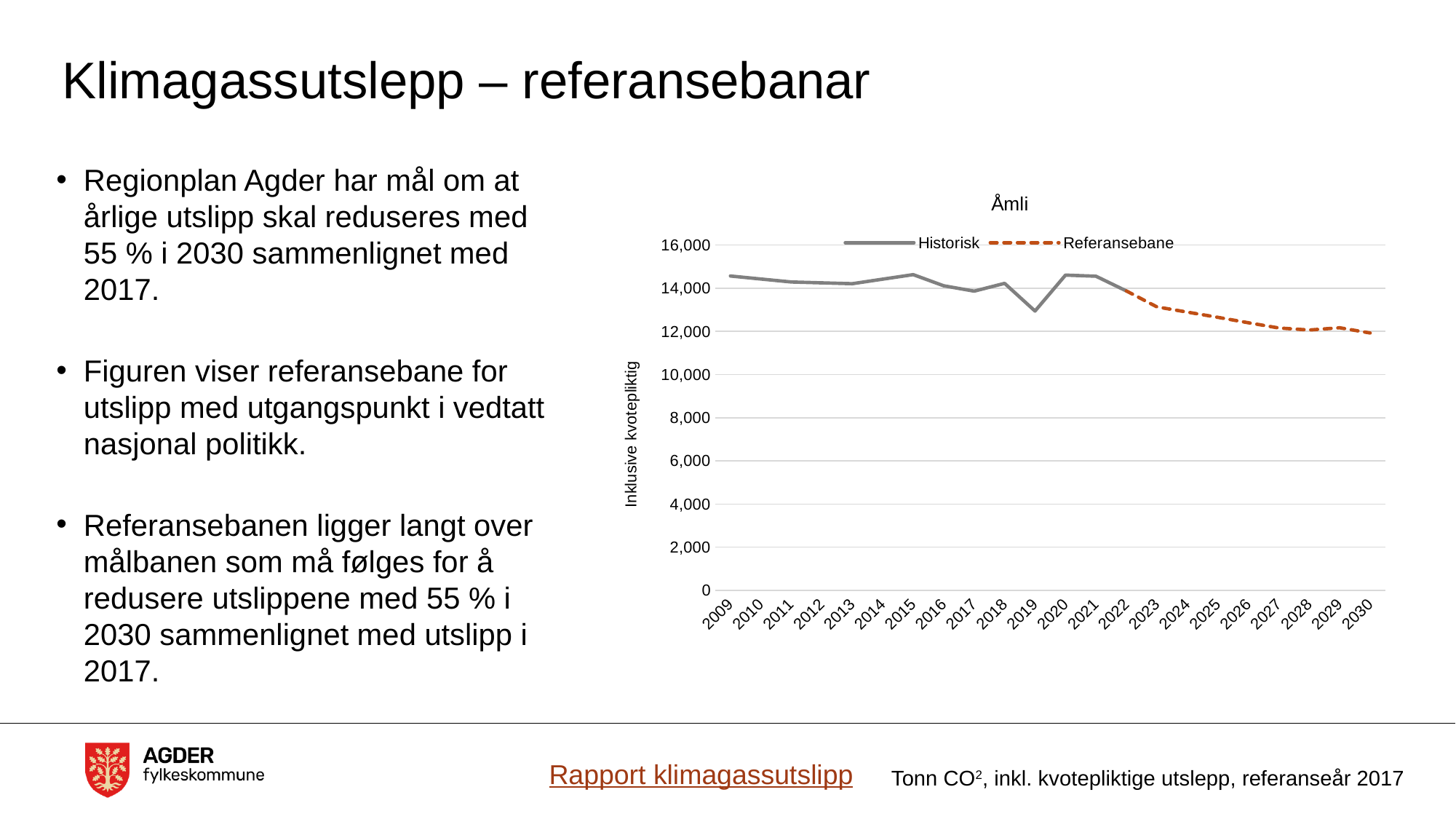
Is the Historisk value for 2009 greater or less than 14,000? greater Which series is drawn with a dashed line? Referansebane Is the Referansebane value for 2025 greater or less than 14,000? less How many series does the chart legend list? 2 What kind of chart is shown on the slide? line chart Is the Historisk value for 2019 greater or less than 14,000? less What is the title of the chart? Åmli In which year does the Historisk series reach its lowest value? 2019 Does the Referansebane series rise or fall from 2022 to 2030? fall How many years are shown along the x axis of the chart? 22 Which year has the larger Historisk value, 2019 or 2020? 2020